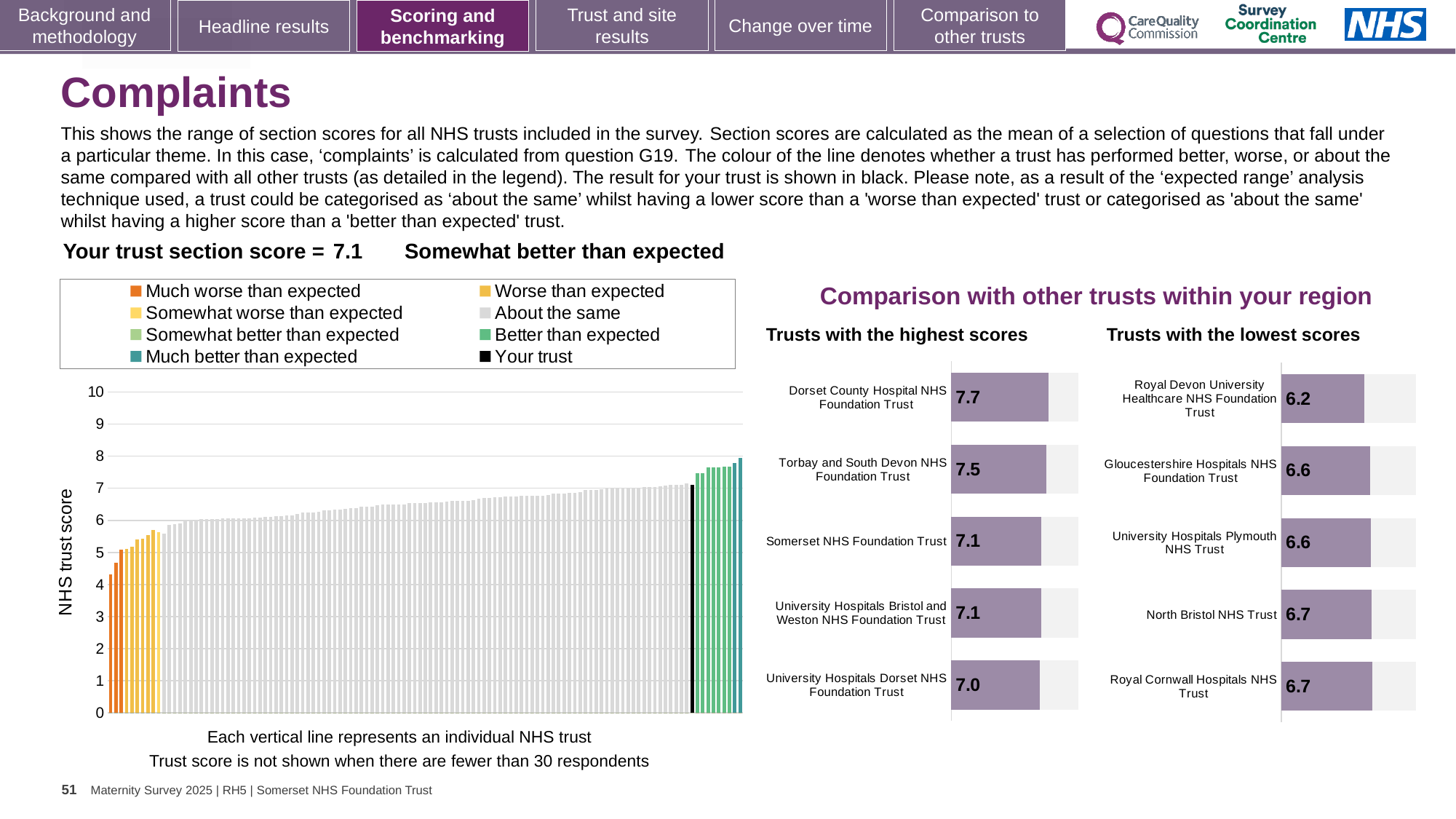
How many entries does the legend of the main 'NHS trust score' chart list? 8 In the 'Trusts with the highest scores' chart, what is the score for University Hospitals Dorset NHS Foundation Trust? 7.0 In the 'Trusts with the lowest scores' chart, what is the score for North Bristol NHS Trust? 6.7 In the 'Trusts with the lowest scores' chart, which has the larger score: Gloucestershire Hospitals NHS Foundation Trust or Royal Cornwall Hospitals NHS Trust? Royal Cornwall Hospitals NHS Trust In the 'Trusts with the highest scores' chart, which trust has the highest score? Dorset County Hospital NHS Foundation Trust In the 'Trusts with the lowest scores' chart, which trust has the lowest score? Royal Devon University Healthcare NHS Foundation Trust In the 'Trusts with the highest scores' chart, how many trusts are shown? 5 In the main 'NHS trust score' chart, is the value of the tallest bar greater or less than 8? less In the main 'NHS trust score' chart, what is the section score for your trust (the black bar)? 7.1 In the 'Trusts with the highest scores' chart, what is the difference between the scores of Dorset County Hospital NHS Foundation Trust and Torbay and South Devon NHS Foundation Trust? 0.2 In the 'Trusts with the highest scores' chart, what is the score for Dorset County Hospital NHS Foundation Trust? 7.7 In the 'Trusts with the lowest scores' chart, what is the score for Royal Devon University Healthcare NHS Foundation Trust? 6.2